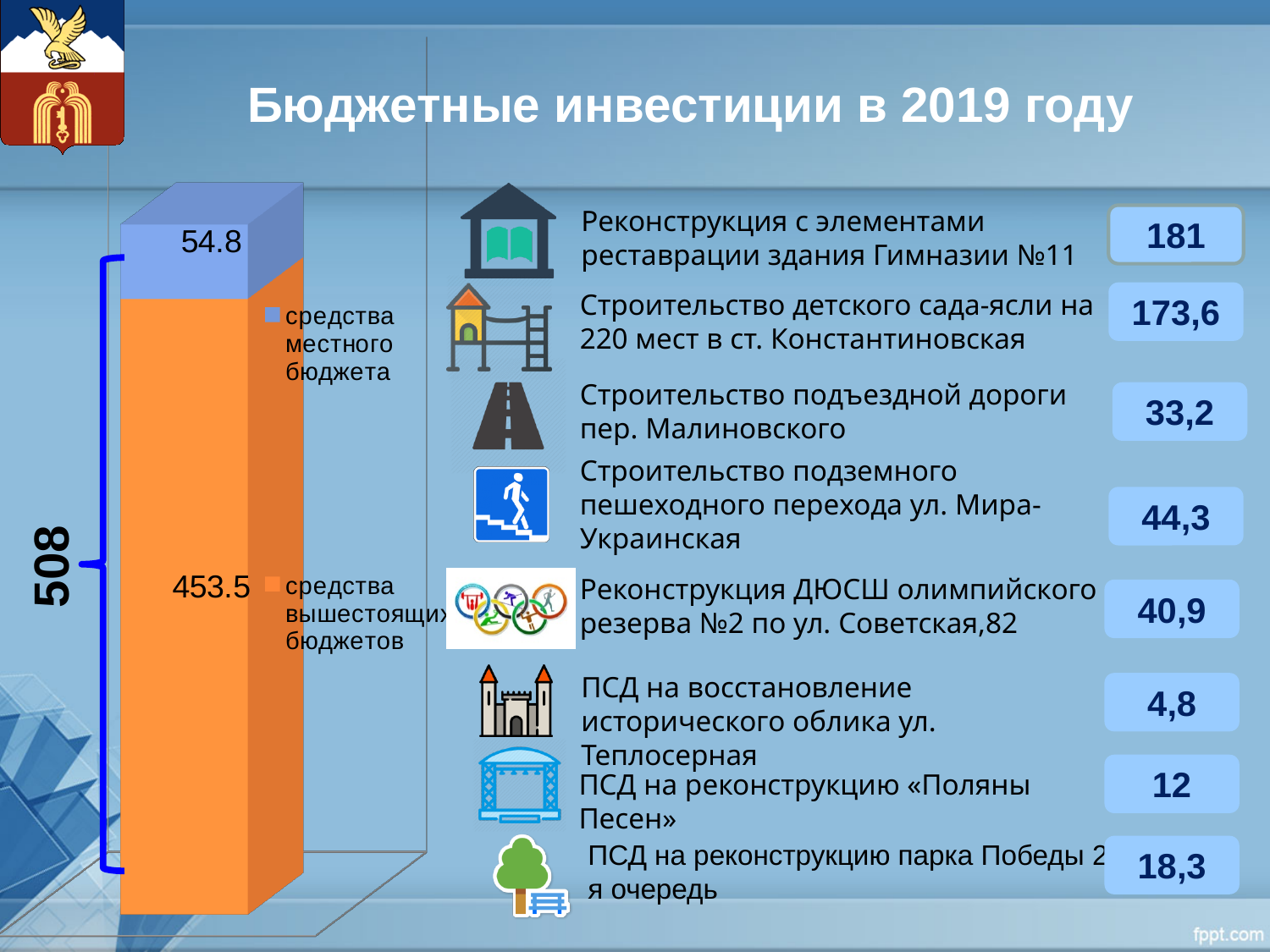
Which series has the largest value in the stacked bar? средства вышестоящих бюджетов Which series has the smallest value in the stacked bar? средства местного бюджета What kind of chart is shown on the left of the slide? stacked bar chart What colour is the segment for средства местного бюджета? blue How many series does the chart legend list? 2 What is the value of the segment labelled "средства местного бюджета" in the stacked bar? 54.8 What is the difference between the two segments of the stacked bar (453.5 and 54.8)? 398.7 Which segment of the stacked bar is larger: средства местного бюджета or средства вышестоящих бюджетов? средства вышестоящих бюджетов How many bars does the chart contain? 1 What is the value of the segment labelled "средства вышестоящих бюджетов" in the stacked bar? 453.5 What colour is the segment for средства вышестоящих бюджетов? orange What is the total of the stacked bar, as shown by the bracket label on the slide? 508